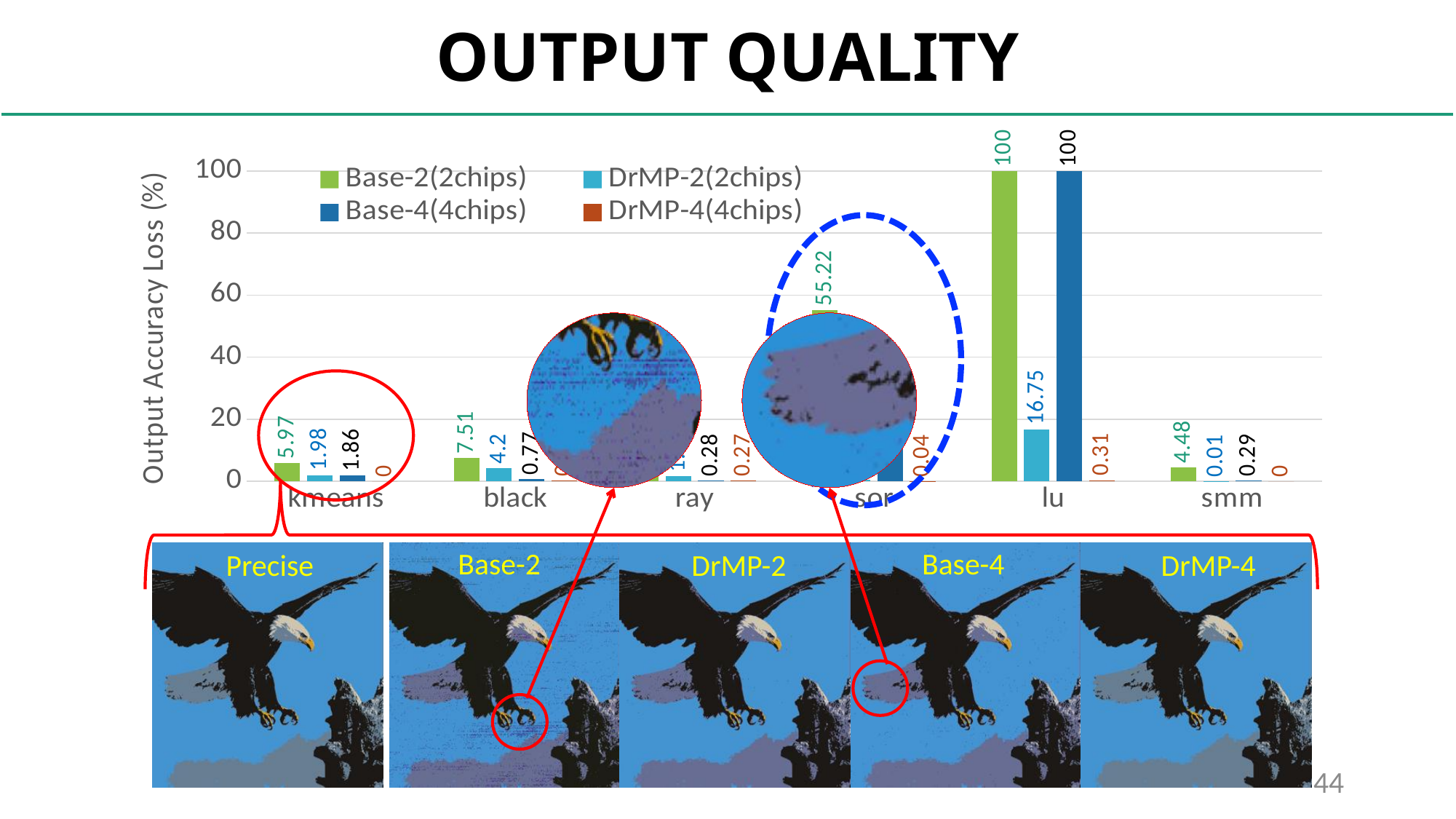
What is the DrMP-4(4chips) output accuracy loss for smm? 0 What is the Base-2(2chips) output accuracy loss for kmeans? 5.97 What is the DrMP-2(2chips) output accuracy loss for lu? 16.75 How many benchmark categories are shown on the x axis of the chart? 6 What is the difference between the Base-2(2chips) and DrMP-2(2chips) output accuracy loss for lu? 83.25 How many series does the chart legend list? 4 What type of chart is shown on the slide? bar chart What is the label of the y axis of the chart? Output Accuracy Loss (%) Which benchmark has the highest Base-2(2chips) output accuracy loss? lu What is the DrMP-2(2chips) output accuracy loss for black? 4.2 For kmeans, which is larger: the DrMP-2(2chips) value or the Base-4(4chips) value? DrMP-2(2chips) What is the Base-2(2chips) output accuracy loss for sor? 55.22